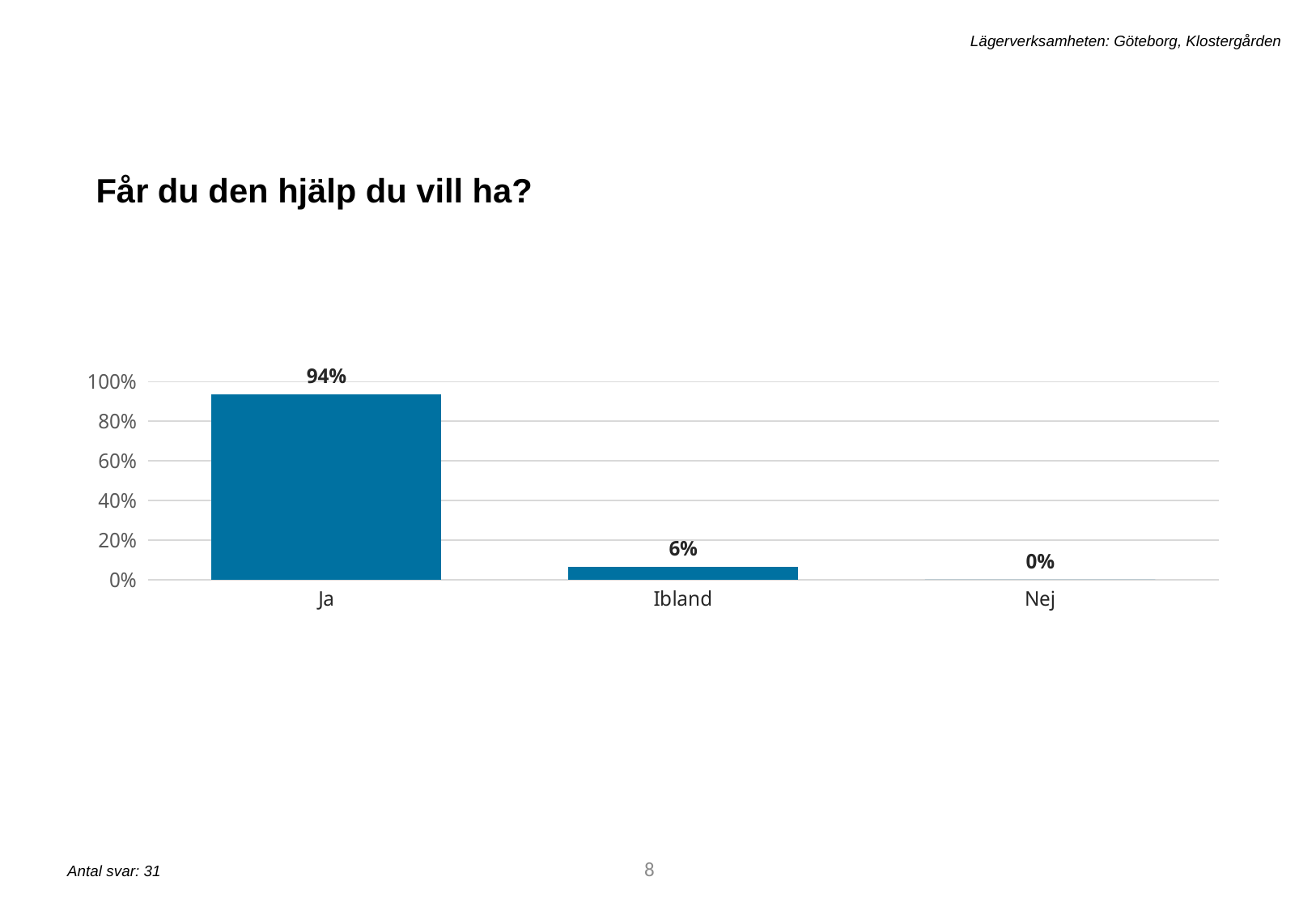
What is the title of the slide above the chart? Får du den hjälp du vill ha? What is the value for Ja? 94% Do the values rise or fall from left to right along the x axis? fall Which category has the lowest value? Nej What is the value for Ibland? 6% Is the value for Ja greater or less than 80%? greater What is the value for Nej? 0% How many categories are shown on the x axis? 3 What is the difference between the values for Ja and Ibland? 88% Which is larger, the value for Ibland or the value for Nej? Ibland What kind of chart is shown on the slide? bar chart Which category has the highest value? Ja